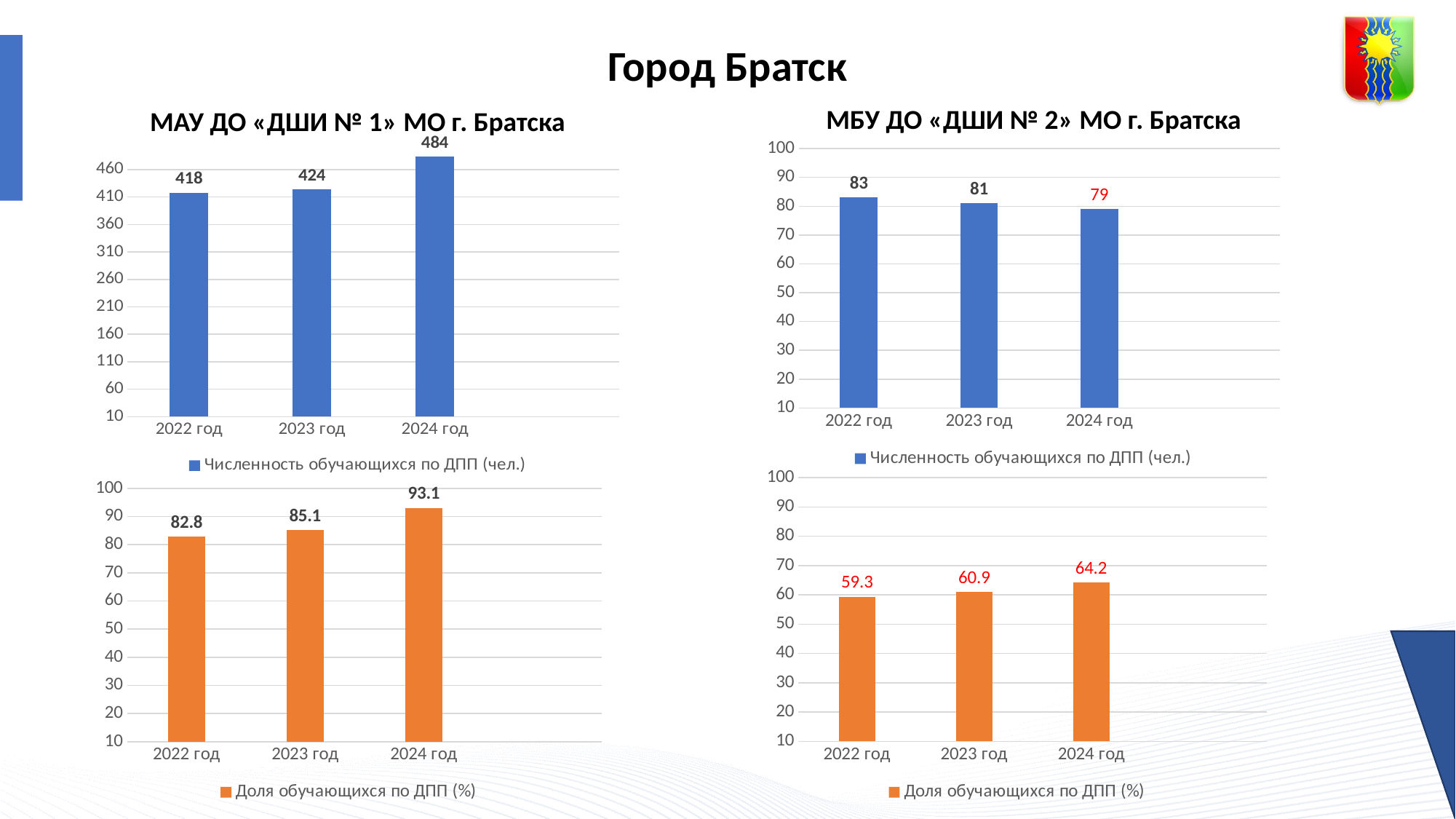
How many years (categories) are shown in the top-left chart (ДШИ № 1, Численность обучающихся по ДПП)? 3 Which is larger: the 2024 год value in the bottom-left chart (ДШИ № 1, Доля обучающихся по ДПП) or the 2024 год value in the bottom-right chart (ДШИ № 2, Доля обучающихся по ДПП)? ДШИ № 1 (93.1) In the top-left chart (ДШИ № 1, Численность обучающихся по ДПП), which year has the lowest value? 2022 год In the top-right chart (ДШИ № 2, Численность обучающихся по ДПП), which year has the highest value? 2022 год In the bottom-left chart (ДШИ № 1, Доля обучающихся по ДПП (%)), what is the value for 2023 год? 85.1 In the bottom-right chart (ДШИ № 2, Доля обучающихся по ДПП (%)), what is the value for 2024 год? 64.2 In the bottom-left chart (ДШИ № 1, Доля обучающихся по ДПП (%)), do the values rise or fall from 2022 год to 2024 год? rise In the top-right chart (МБУ ДО «ДШИ № 2» МО г. Братска, Численность обучающихся по ДПП), what is the value for 2022 год? 83 In the top-right chart (ДШИ № 2, Численность обучающихся по ДПП), do the values rise or fall from 2022 год to 2024 год? fall In the top-left chart (МАУ ДО «ДШИ № 1» МО г. Братска, Численность обучающихся по ДПП), what is the value for 2024 год? 484 In the bottom-right chart (ДШИ № 2, Доля обучающихся по ДПП (%)), what is the difference between the 2024 год and 2022 год values? 4.9 In the top-left chart (ДШИ № 1, Численность обучающихся по ДПП), what is the difference between the 2024 год and 2022 год values? 66